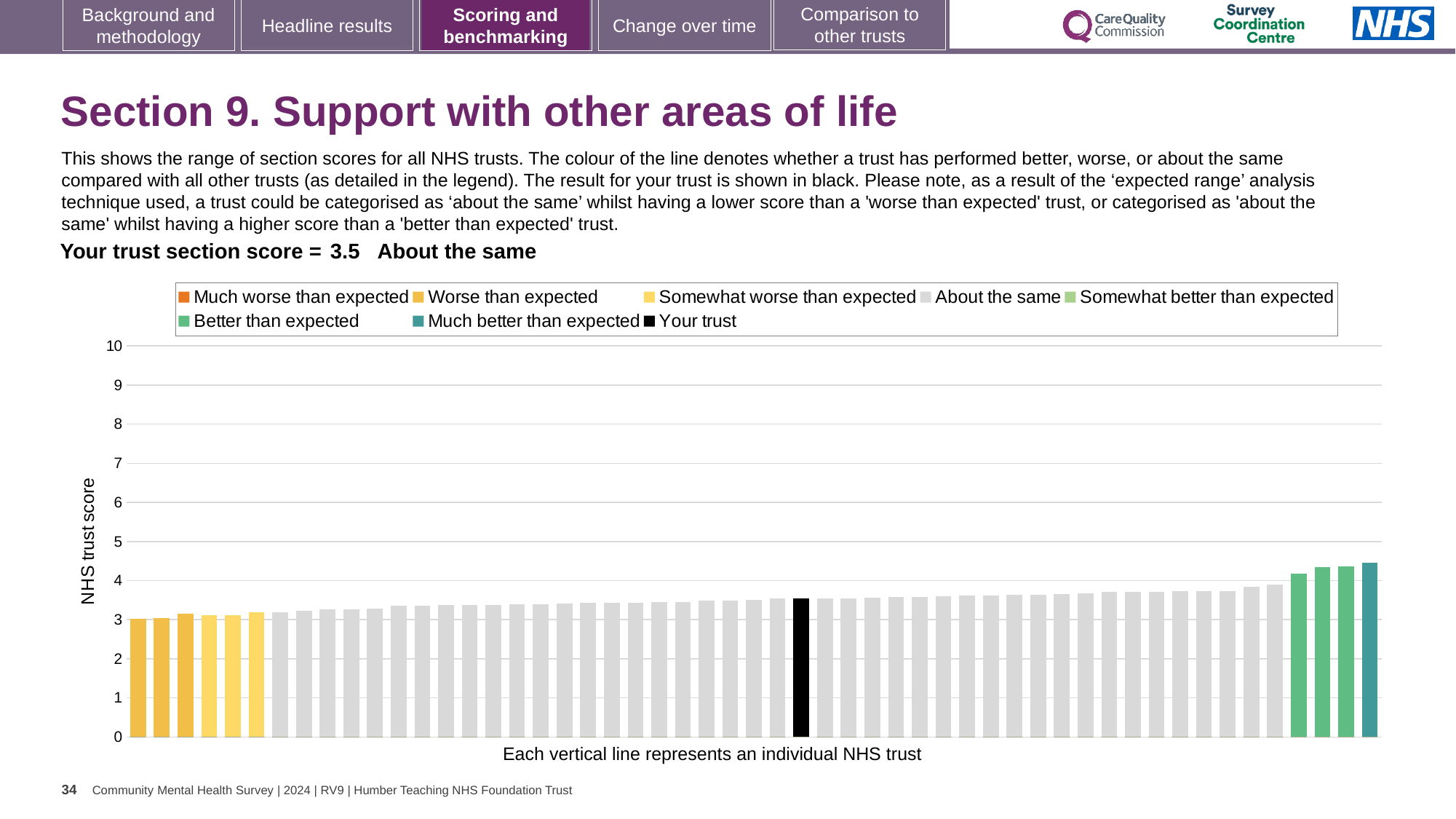
How many entries does the chart legend list? 8 Is the value of the black 'Your trust' bar greater or less than 4? less Do the bar values rise or fall moving from left to right along the x axis? rise What colour is the bar representing your trust? black What is the section score for your trust, as printed on the slide? 3.5 Which is larger: the value of the 'Your trust' bar or the value of the rightmost teal bar? the rightmost teal bar Which category is your trust placed in for this section? About the same What is the label on the vertical axis of the chart? NHS trust score Is the value of the tallest bar greater or less than 5? less Is the value of the tallest bar (the rightmost, teal bar) greater or less than 4? greater What kind of chart is shown on the slide? bar chart